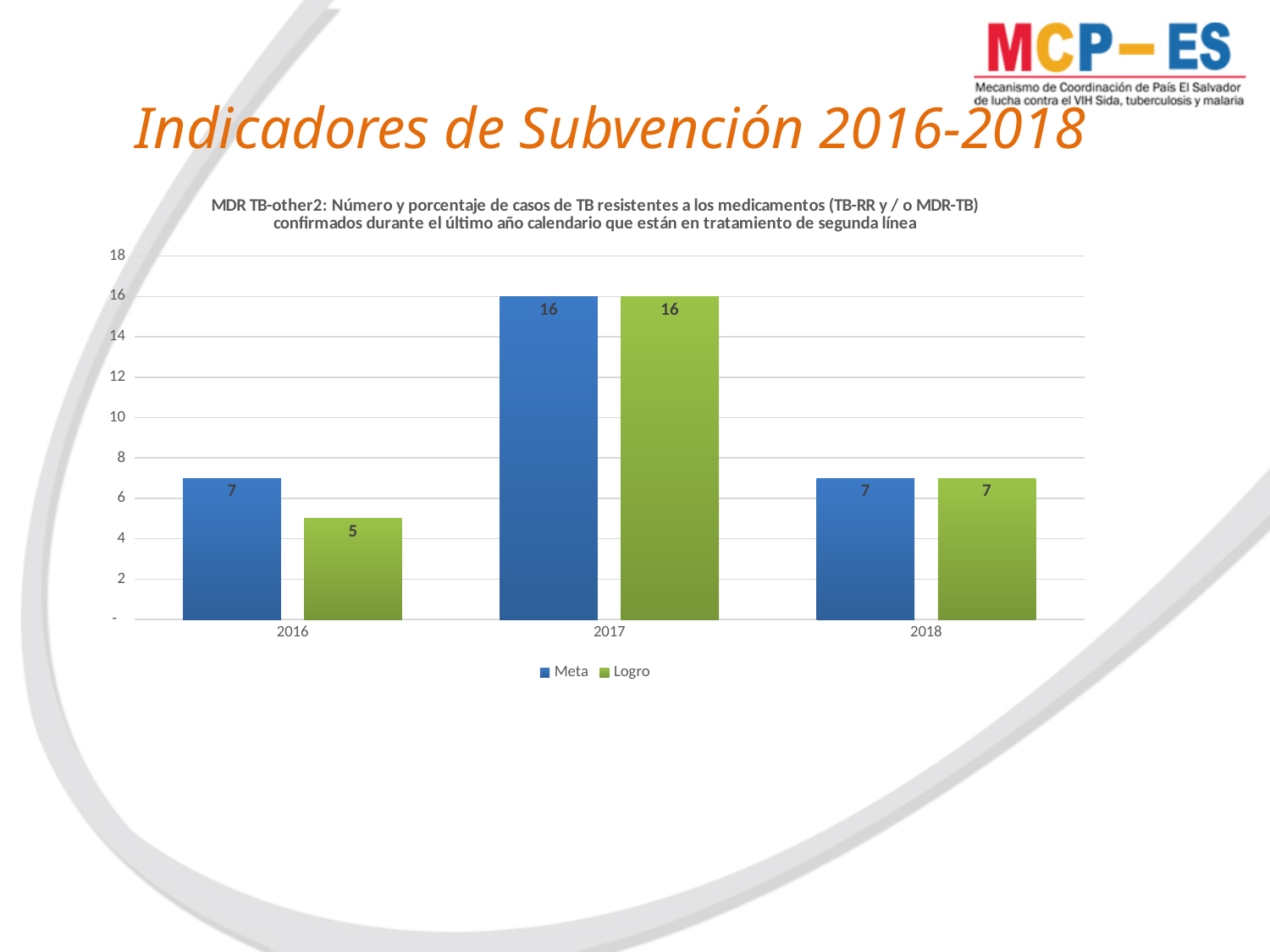
What kind of chart is shown on the slide? Bar chart What is the Meta value for 2018? 7 Is the Logro value for 2017 greater or less than 10? greater How many series does the legend list? 2 How many years are shown on the x axis? 3 Which year has the highest Meta value? 2017 Which year has the lowest Logro value? 2016 What is the Logro value for 2017? 16 What is the Logro value for 2016? 5 Which is larger in 2016, Meta or Logro? Meta What is the difference between the Meta and Logro values for 2016? 2 What is the Meta value for 2016? 7